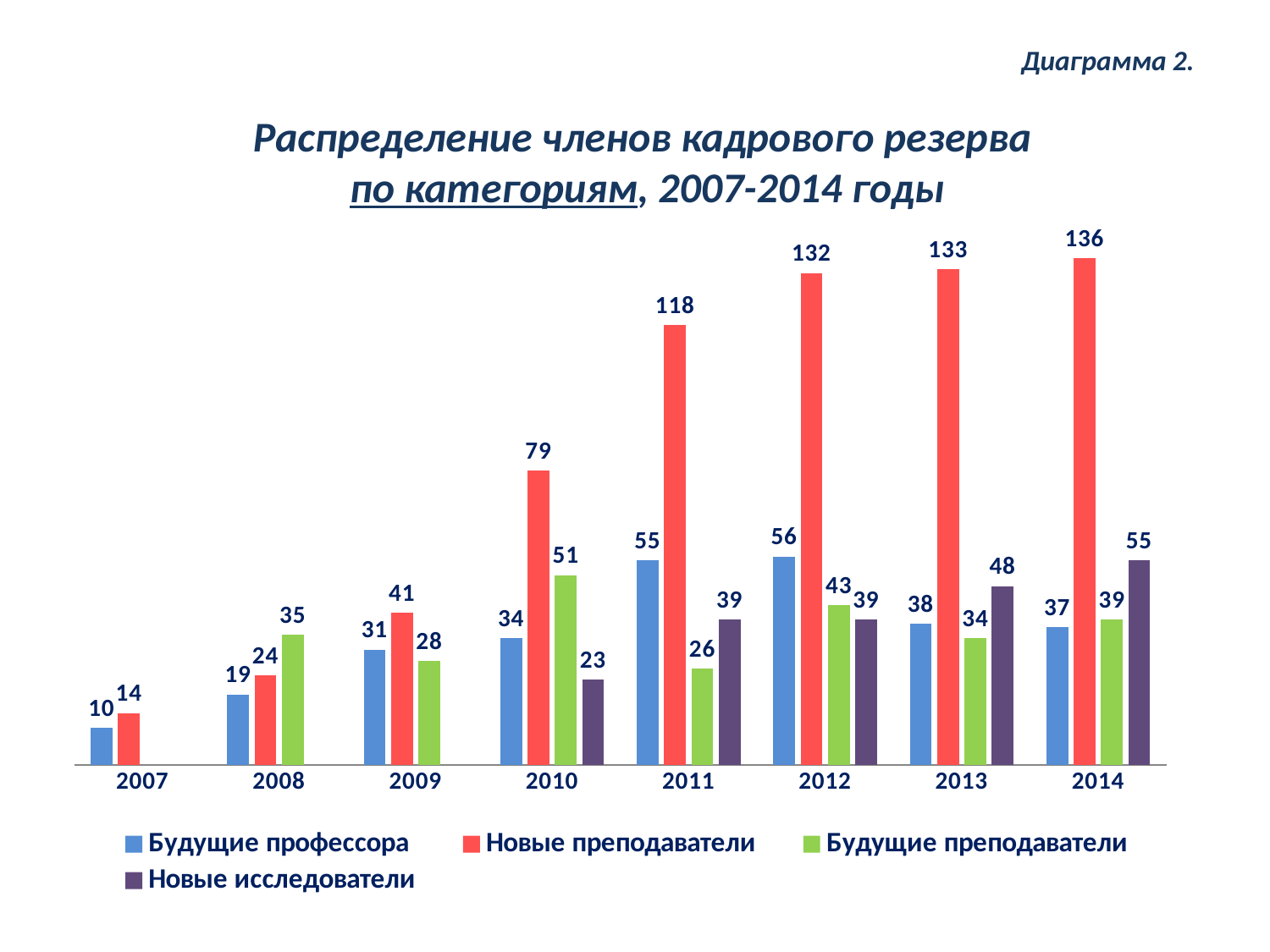
What is the value for Новые преподаватели in 2014? 136 Does the value for Новые преподаватели rise or fall from 2007 to 2014? Rise How many series does the legend list? 4 What is the value for Будущие профессора in 2011? 55 Which is larger in 2013: Будущие профессора or Новые исследователи? Новые исследователи What is the value for Будущие преподаватели in 2008? 35 In which year is the value for Новые преподаватели the highest? 2014 What is the value for Новые исследователи in 2010? 23 What is the difference between the Новые преподаватели values in 2012 and 2010? 53 How many years are shown on the x axis? 8 What kind of chart is shown on the slide? Bar chart In which year is the value for Будущие профессора the lowest? 2007